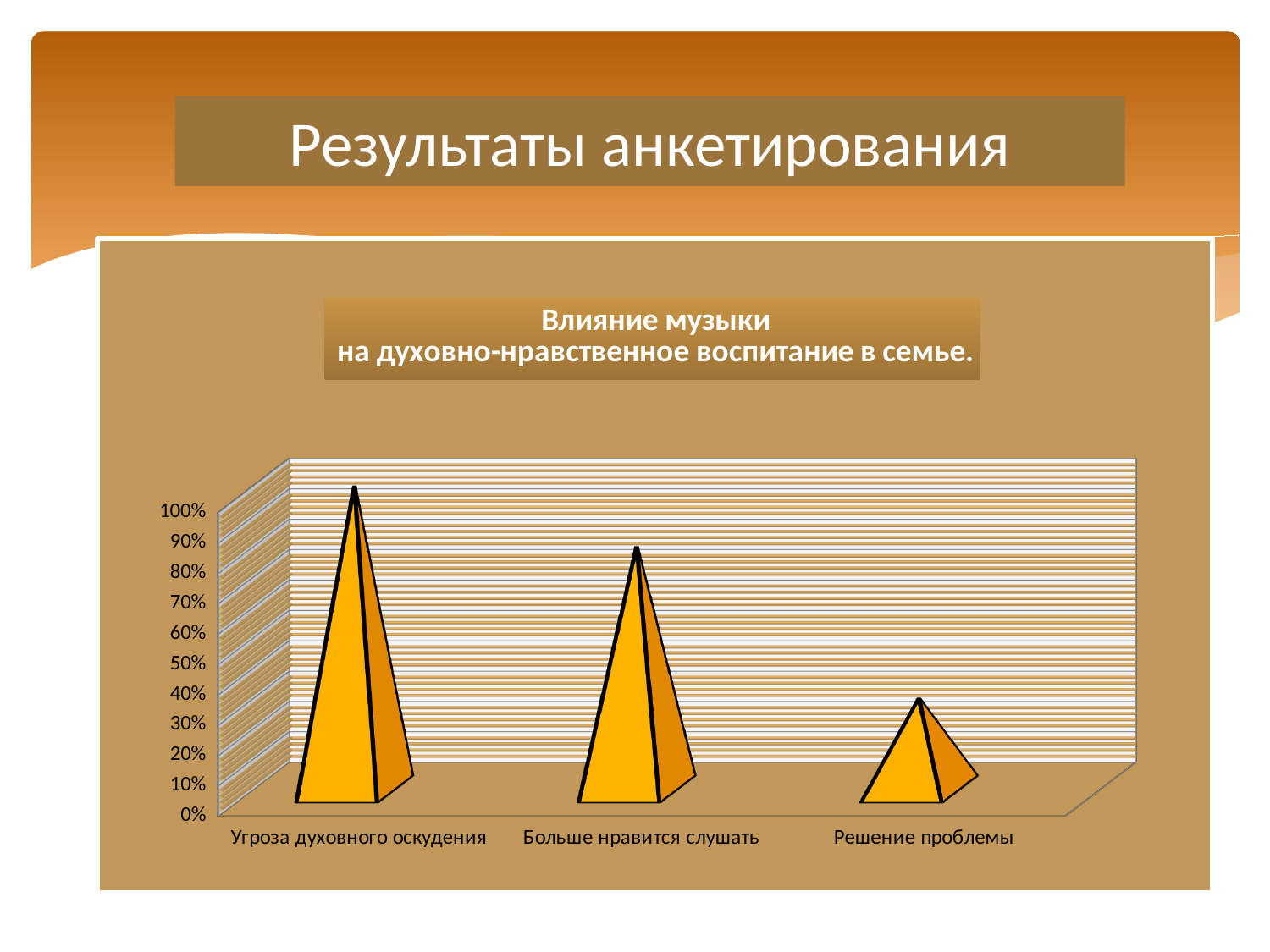
Which is larger: the value for "Больше нравится слушать" or the value for "Решение проблемы"? Больше нравится слушать Which category has the lowest value in the chart? Решение проблемы What kind of chart is shown on the slide? bar chart How many categories are shown on the x axis of the chart? 3 What is the title of the chart? Влияние музыки на духовно-нравственное воспитание в семье. Is the value for "Решение проблемы" greater or less than 20%? greater Is the value for "Решение проблемы" greater or less than 50%? less Is the value for "Больше нравится слушать" greater or less than 60%? greater Which category has the highest value in the chart? Угроза духовного оскудения Which is larger: the value for "Угроза духовного оскудения" or the value for "Больше нравится слушать"? Угроза духовного оскудения Do the values rise or fall from left to right along the x axis? fall